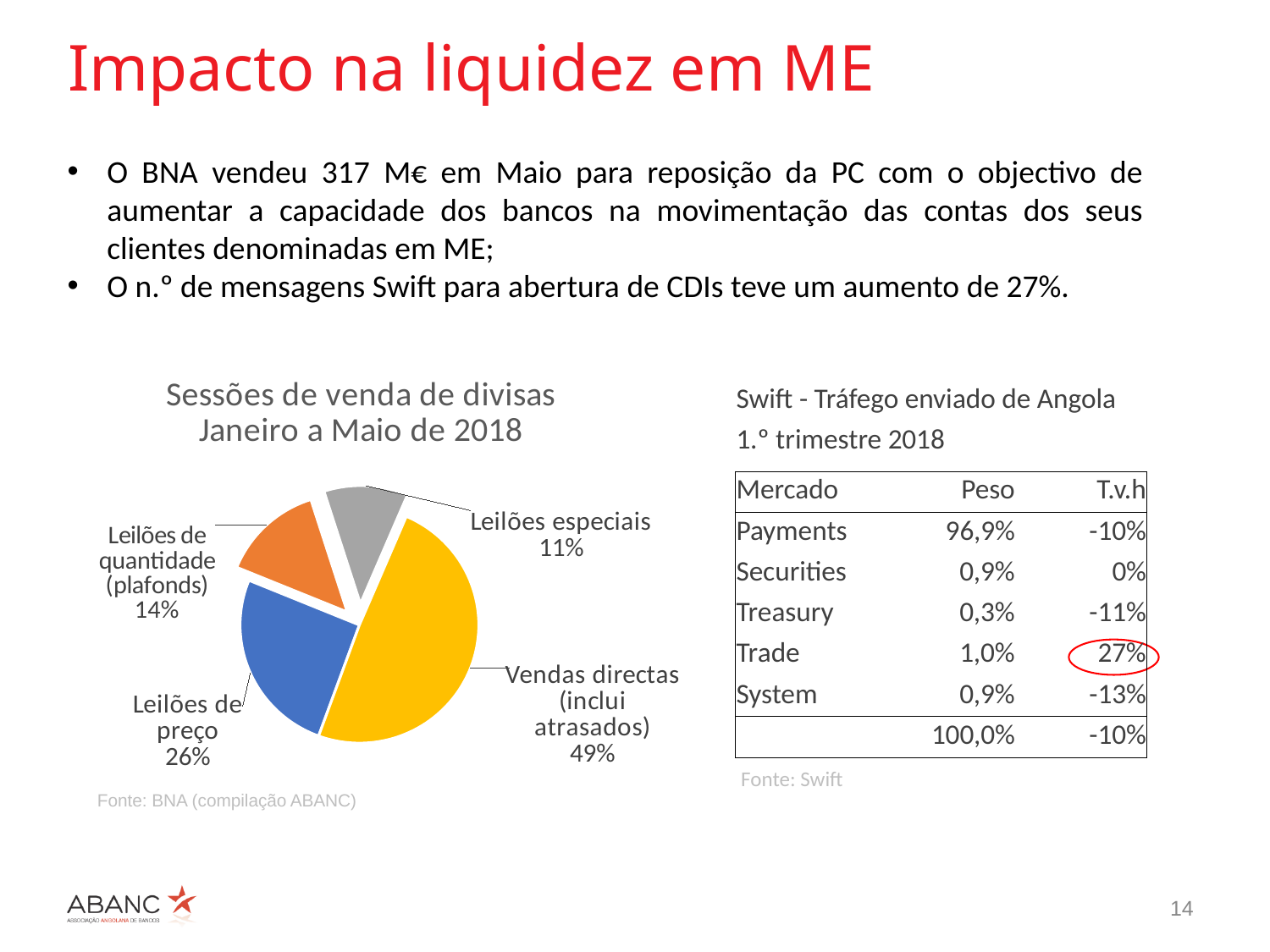
Which category has the smallest slice of the pie? Leilões especiais What kind of chart is shown on the slide? Pie chart What share of the pie is Vendas directas (inclui atrasados)? 49% Which category has the largest slice of the pie? Vendas directas (inclui atrasados) How many slices does the pie chart have? 4 What share of the pie is Leilões especiais? 11% What is the title of the pie chart? Sessões de venda de divisas Janeiro a Maio de 2018 What is the source cited below the pie chart? BNA (compilação ABANC) What share of the pie is Leilões de quantidade (plafonds)? 14% What is the difference in percentage points between Vendas directas (inclui atrasados) and Leilões de preço? 23 Which is larger, the share for Leilões de quantidade (plafonds) or the share for Leilões especiais? Leilões de quantidade (plafonds)